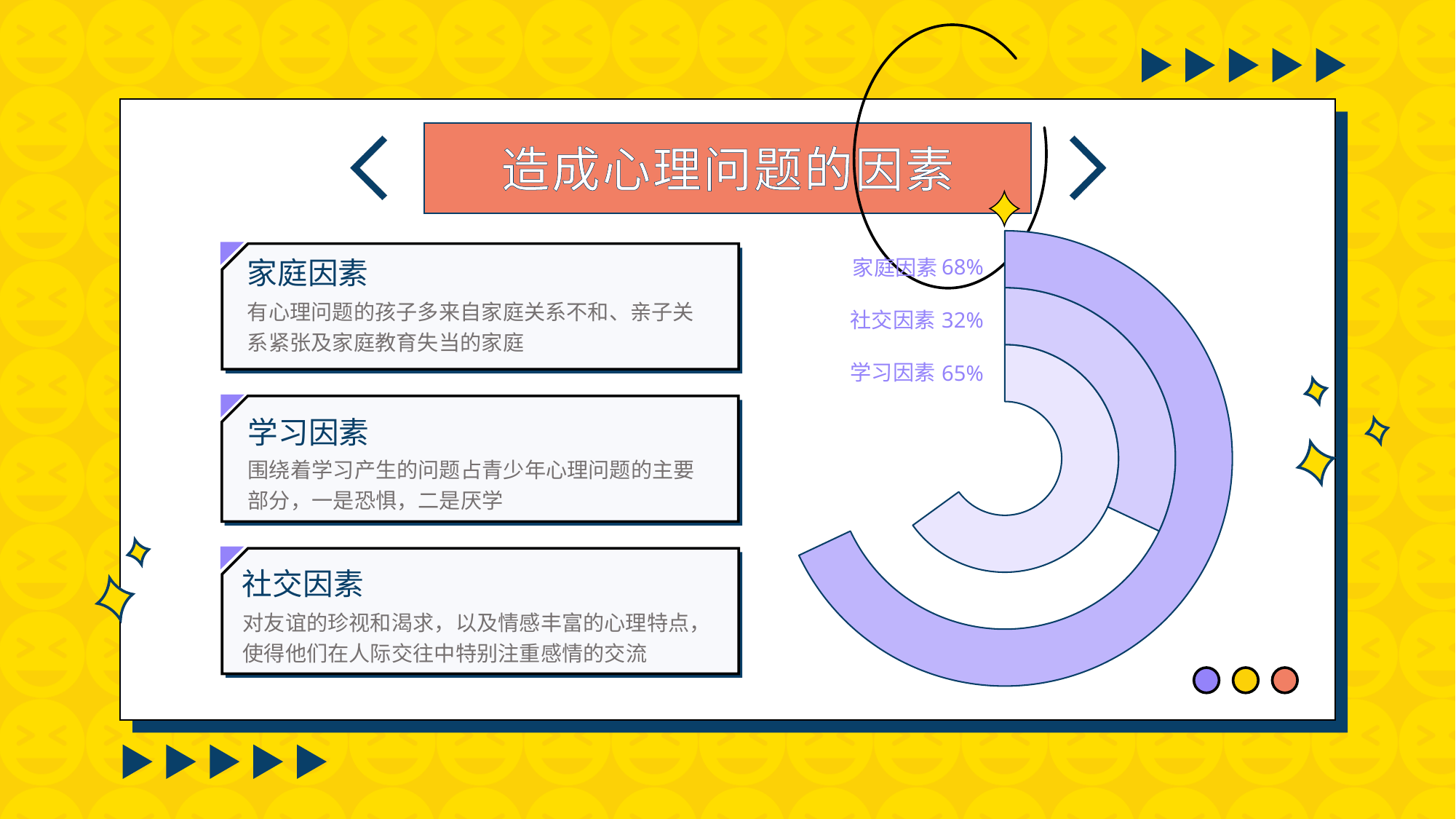
What is the title of the slide containing the chart? 造成心理问题的因素 Which factor has the highest percentage in the chart? 家庭因素 What kind of chart is shown on the slide? Doughnut chart What is the difference between the percentages for 家庭因素 and 社交因素? 36% What is the difference between the percentages for 学习因素 and 社交因素? 33% How many factors are plotted in the chart? 3 What is the value shown for 学习因素 in the chart? 65% What is the difference between the percentages for 家庭因素 and 学习因素? 3% What is the value shown for 家庭因素 in the chart? 68% Which factor has the lowest percentage in the chart? 社交因素 Which is larger, the value for 学习因素 or the value for 社交因素? 学习因素 What is the value shown for 社交因素 in the chart? 32%